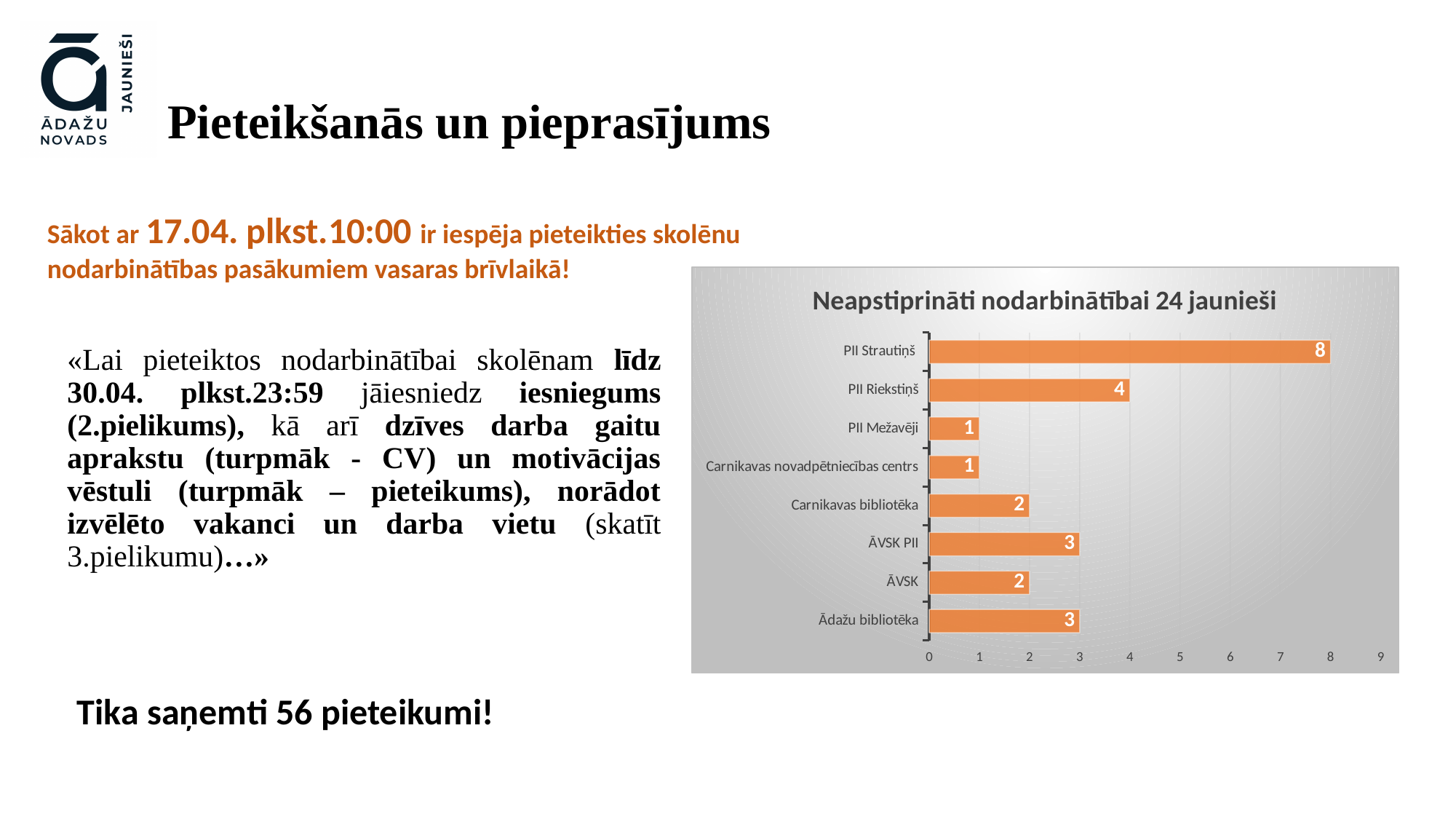
What is the highest value shown on the x axis? 9 How many categories are shown in the chart? 8 What is the difference between the values for PII Strautiņš and PII Riekstiņš? 4 Which is larger, the value for ĀVSK PII or the value for ĀVSK? ĀVSK PII What is the title of the chart? Neapstiprināti nodarbinātībai 24 jaunieši What is the value for PII Strautiņš? 8 What is the value for Ādažu bibliotēka? 3 What is the value for PII Riekstiņš? 4 What is the value for Carnikavas bibliotēka? 2 Which category has the highest value? PII Strautiņš What kind of chart is shown on the slide? bar chart Is the value for PII Strautiņš greater or less than 5? greater